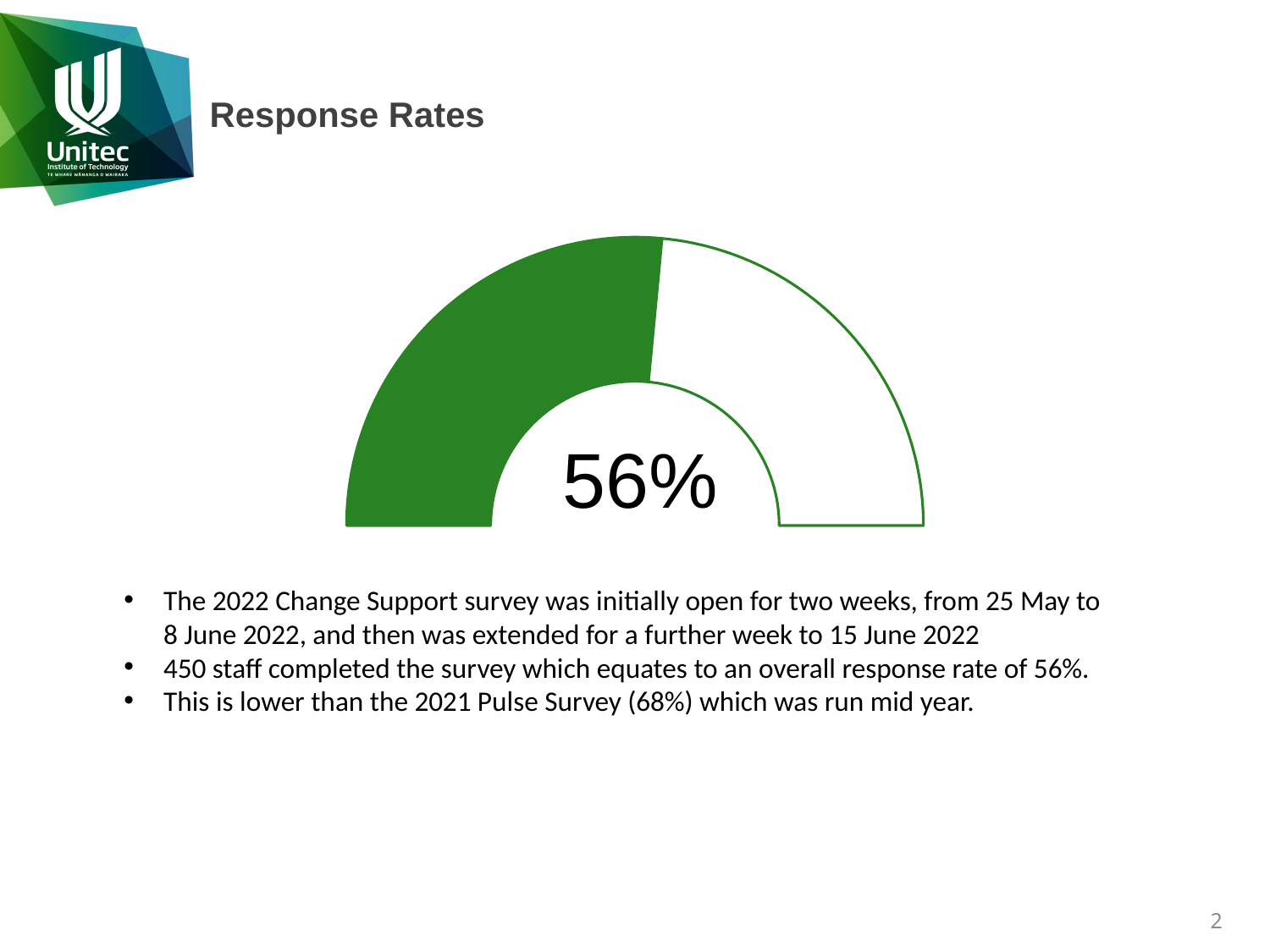
What kind of chart is shown on the slide? gauge chart Is the value shown on the gauge chart greater or less than 50%? greater What colour is the filled portion of the gauge chart? green What value is displayed in the centre of the gauge chart? 56% How many data values are labelled on the gauge chart? 1 What is the title of the slide containing the gauge chart? Response Rates Is the filled green portion of the gauge larger or smaller than the unfilled white portion? larger